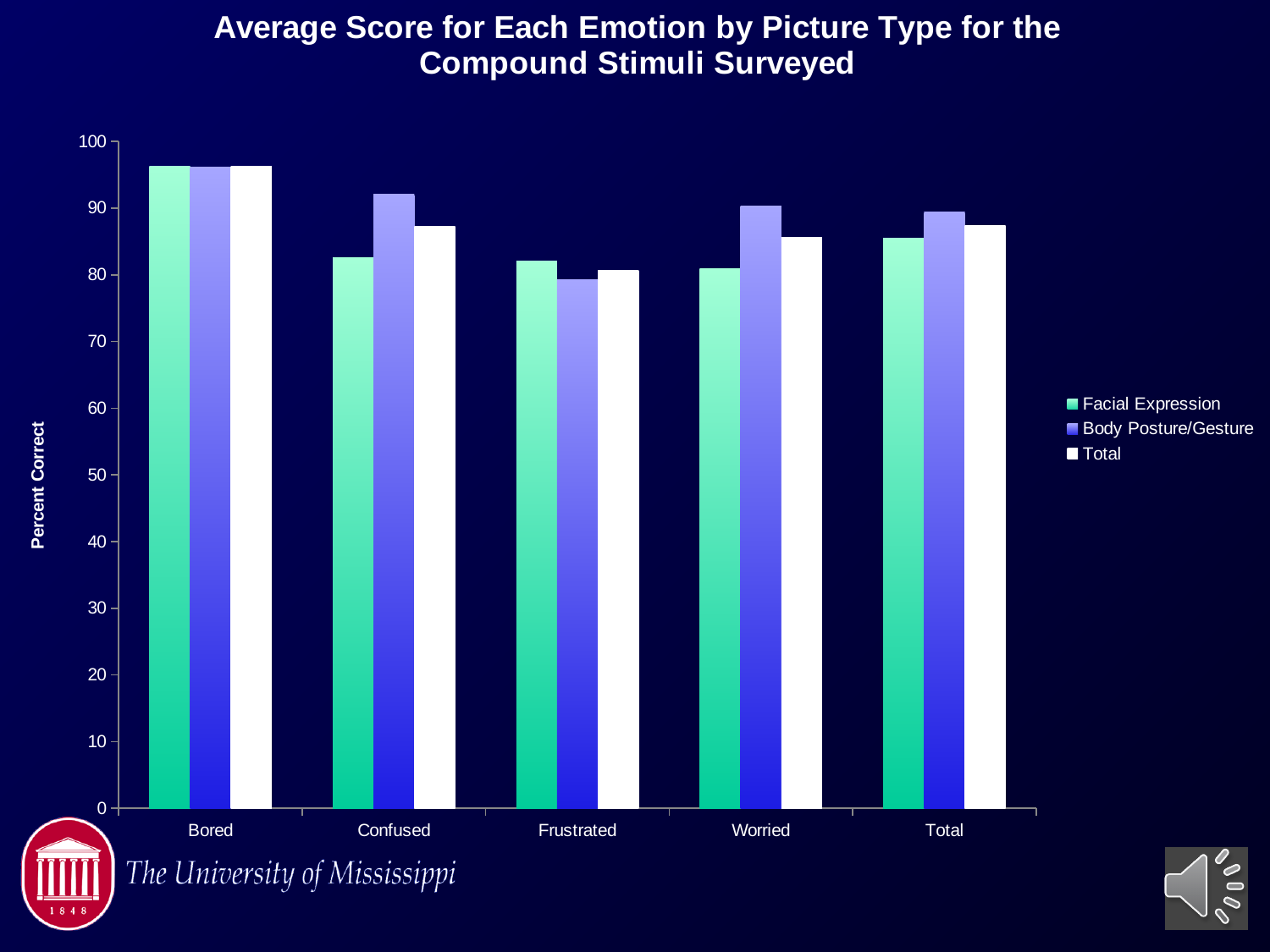
For which emotion is the Total score lowest? Frustrated Which series is shown in white in the legend? Total How many emotion categories are shown on the x axis? 5 Is the Facial Expression value for Confused greater or less than 90? less Is the Facial Expression value for Bored greater or less than 90? greater How many series does the legend list? 3 For Worried, which is larger: the Facial Expression score or the Body Posture/Gesture score? Body Posture/Gesture What kind of chart is shown on the slide? bar chart For which emotion is the Body Posture/Gesture score lowest? Frustrated For which emotion is the Facial Expression score highest? Bored For Confused, which is larger: the Facial Expression score or the Body Posture/Gesture score? Body Posture/Gesture What is the label on the vertical axis? Percent Correct